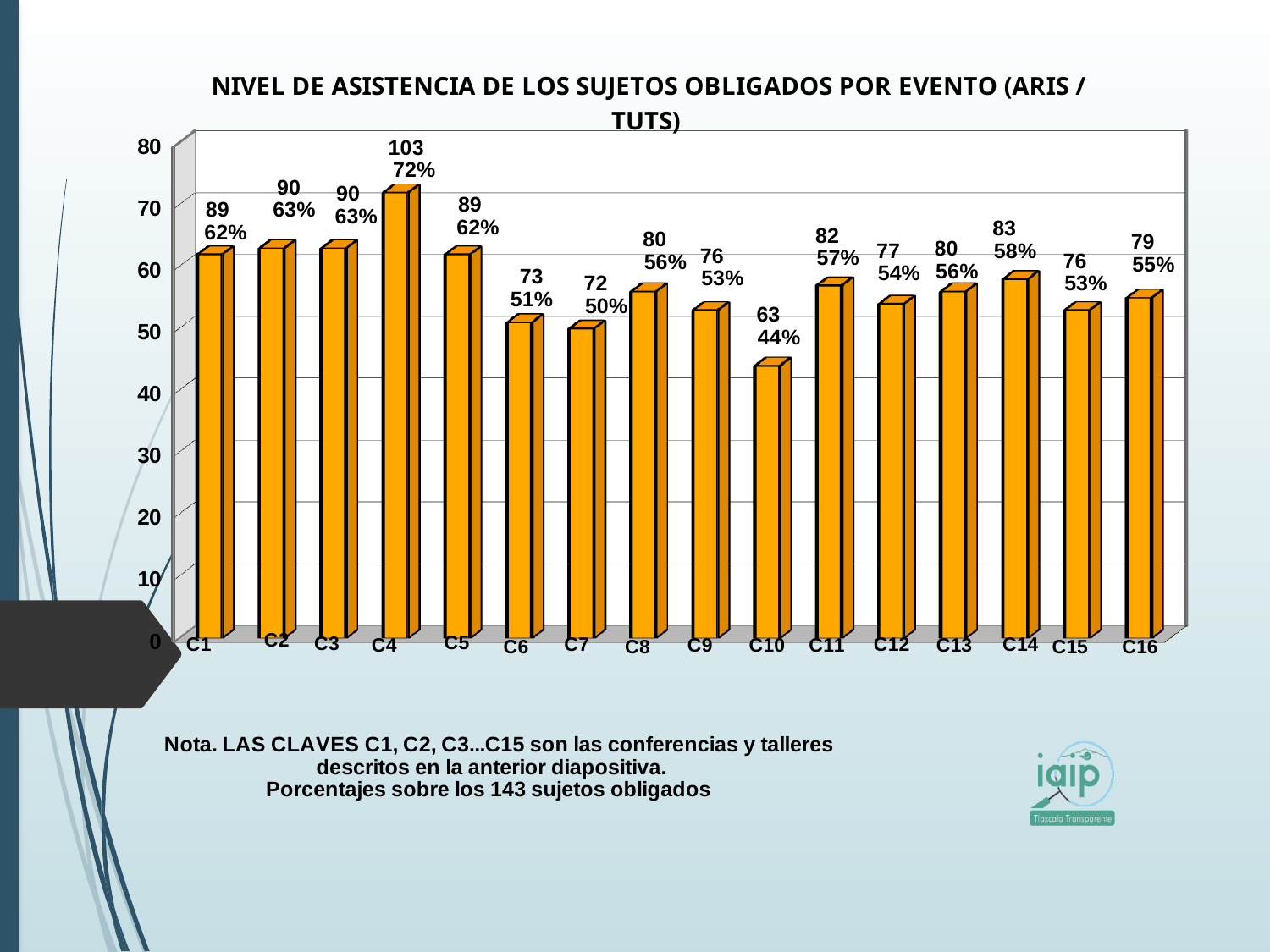
How many events (categories) are shown on the x axis? 16 Which event has the lowest attendance? C10 What is the title of the chart? NIVEL DE ASISTENCIA DE LOS SUJETOS OBLIGADOS POR EVENTO (ARIS / TUTS) What is the attendance count shown for C14? 83 What is the attendance count shown for C4? 103 Is the bar for C6 greater or less than 40 on the axis? greater What percentage is shown for C10? 44% Which event has the highest attendance? C4 Which has a higher attendance count, C8 or C11? C11 What percentage is shown for C7? 50% What kind of chart is shown on the slide? Bar chart What is the difference between the attendance counts for C4 and C10? 40